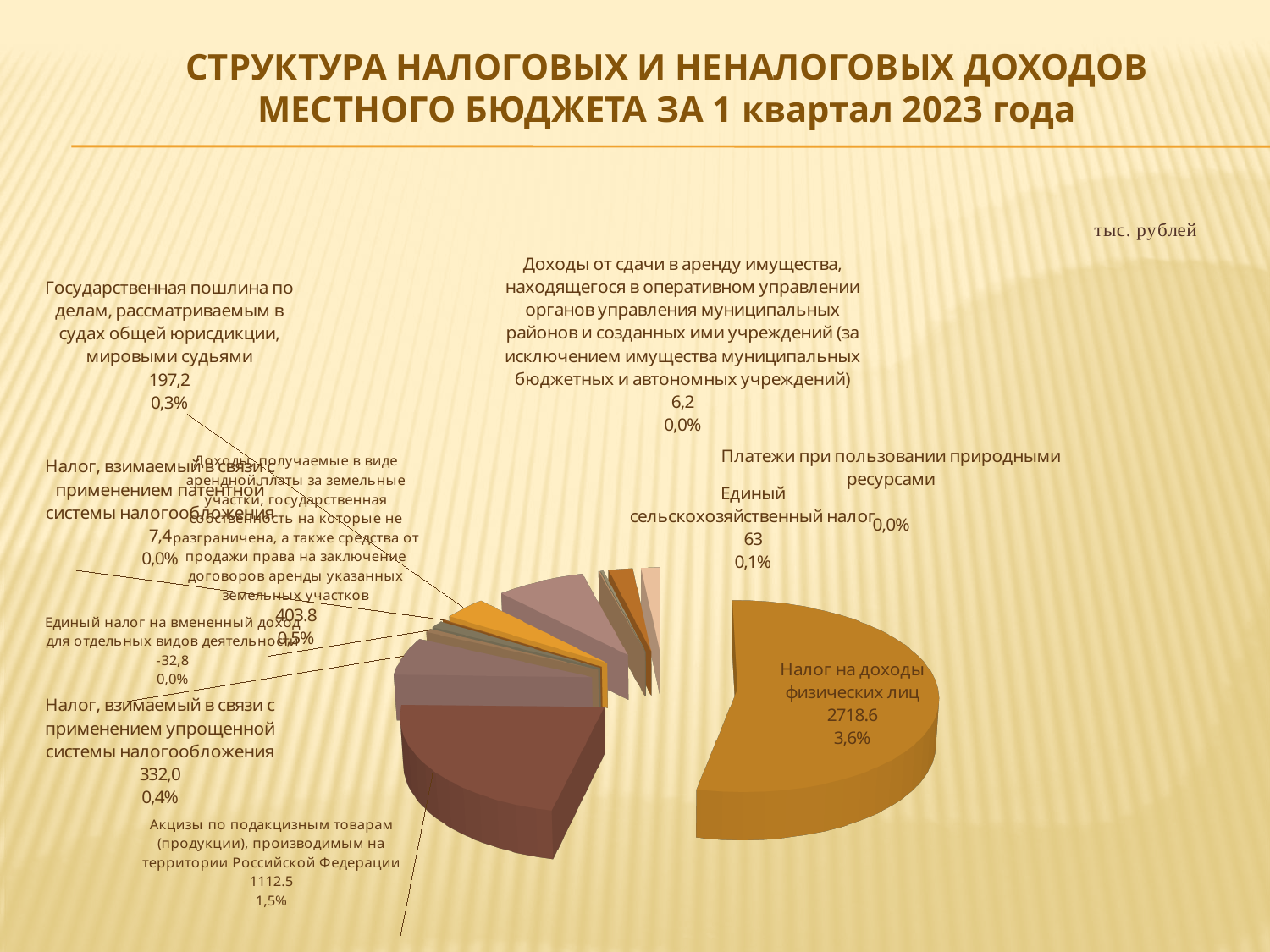
In what units are the chart values given, according to the note on the slide? тыс. рублей What is the value shown for Акцизы по подакцизным товарам (продукции), производимым на территории Российской Федерации? 1112.5 What kind of chart is shown on the slide? pie chart What is the value shown for Налог на доходы физических лиц? 2718.6 Which category has the lowest value in the pie chart? Единый налог на вмененный доход для отдельных видов деятельности What percentage label is shown for the Налог на доходы физических лиц slice? 3,6% What is the difference between the values for Налог на доходы физических лиц and Акцизы по подакцизным товарам? 1606.1 What is the value shown for Государственная пошлина по делам, рассматриваемым в судах общей юрисдикции, мировыми судьями? 197,2 What is the value shown for Налог, взимаемый в связи с применением упрощенной системы налогообложения? 332,0 Which is larger: the value for Акцизы по подакцизным товарам or the value for Налог, взимаемый в связи с применением упрощенной системы налогообложения? Акцизы по подакцизным товарам Which category has the largest value in the pie chart? Налог на доходы физических лиц What is the value shown for Единый сельскохозяйственный налог? 63